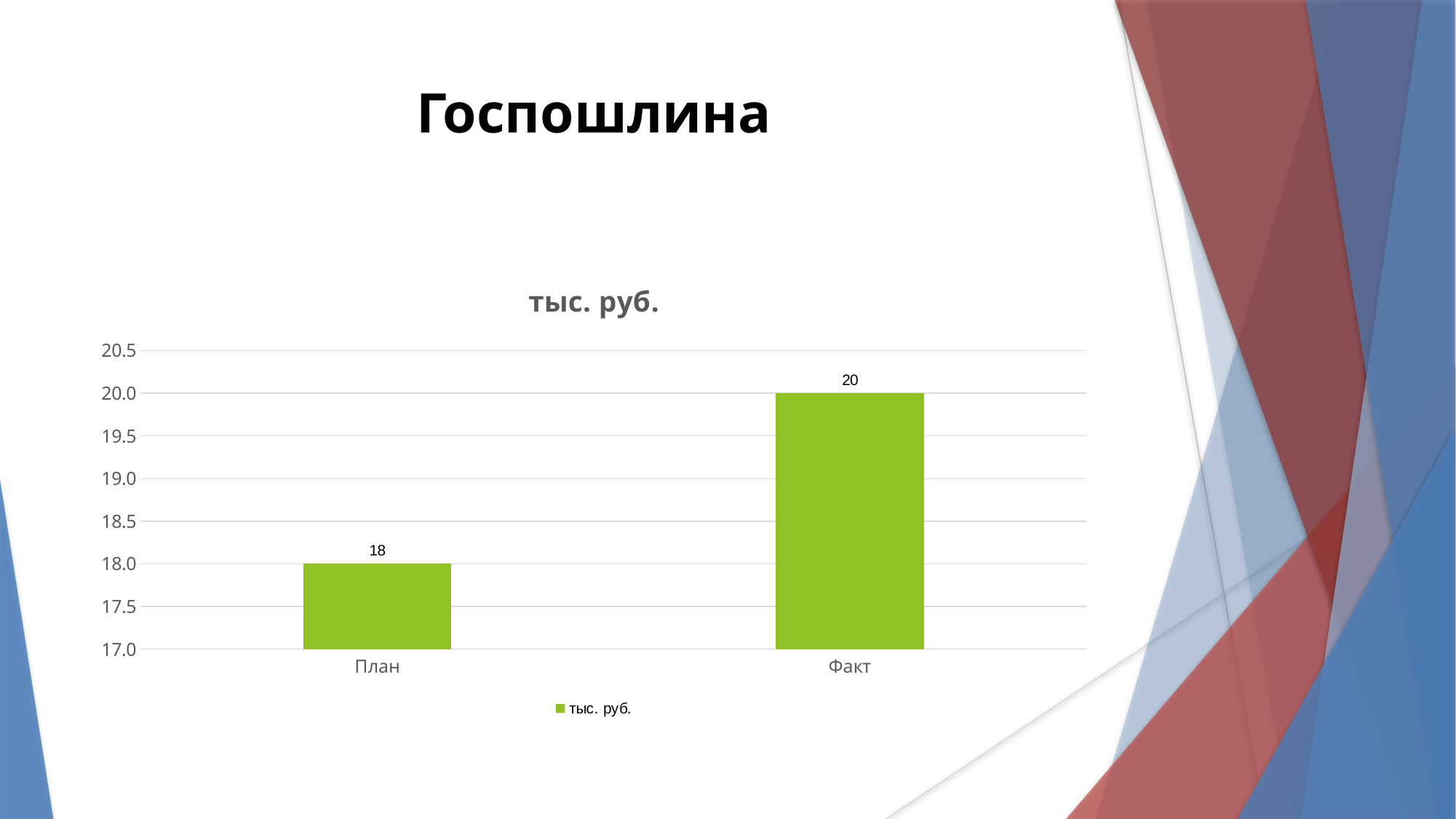
Is the value for План greater or less than 19.0? less Which category has the highest value? Факт How many categories are shown on the x axis? 2 What is the value for Факт? 20 Is the value for Факт greater or less than 19.0? greater What is the value for План? 18 What is the title of the chart? тыс. руб. What kind of chart is shown? bar chart What is the difference between the values for Факт and План? 2 Which category has the lowest value? План How many series does the legend list? 1 Which is larger, the value for План or the value for Факт? Факт